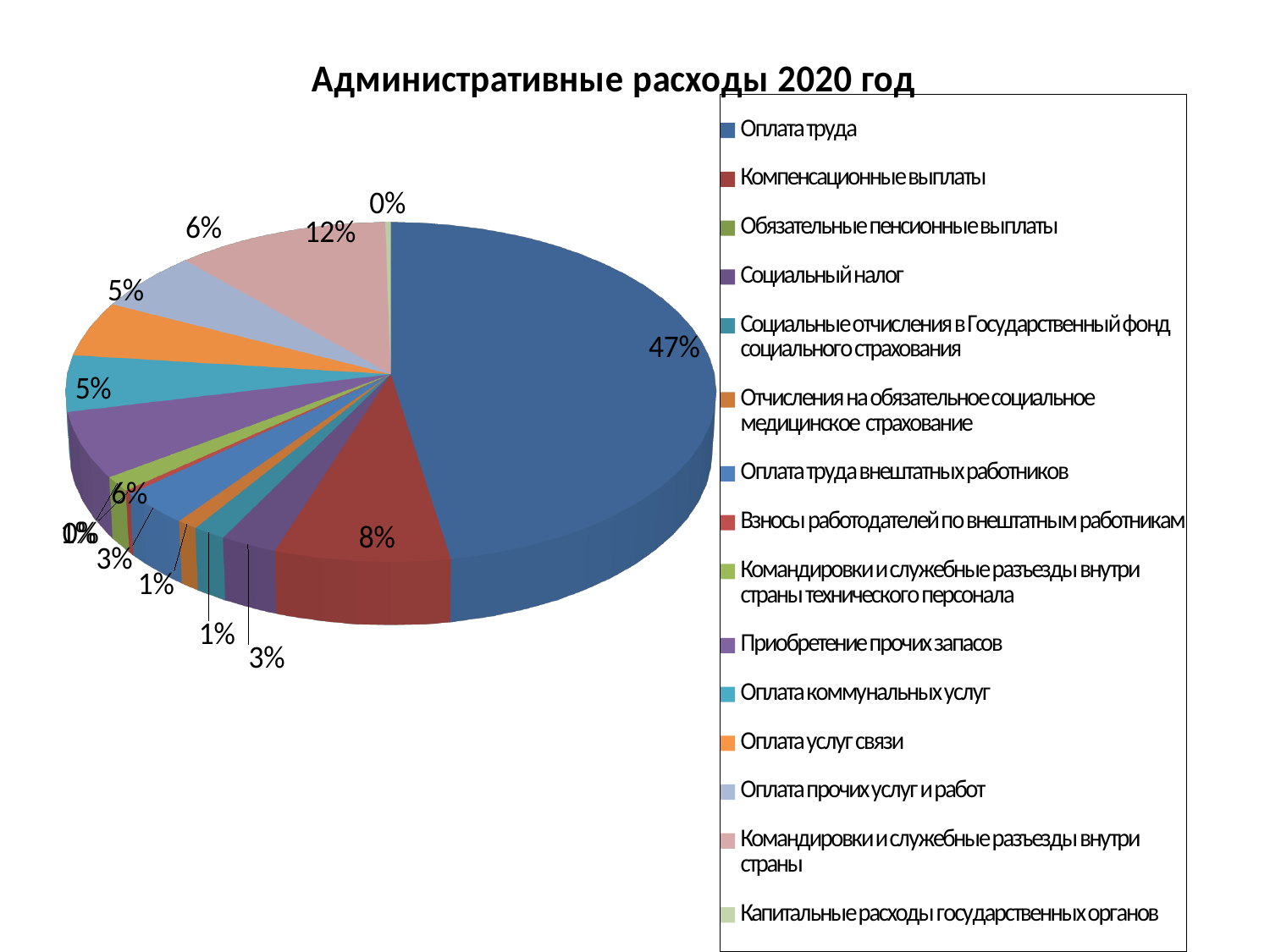
What share of the pie is Капитальные расходы государственных органов? 0% What share of the pie is Оплата прочих услуг и работ? 6% What share of the pie is Компенсационные выплаты? 8% What share of the pie is Командировки и служебные разъезды внутри страны? 12% By how many percentage points does the share for Оплата труда exceed the share for Командировки и служебные разъезды внутри страны? 35 Which category has the largest share of the pie? Оплата труда Which is larger: the share for Оплата труда or the share for Компенсационные выплаты? Оплата труда How many categories does the legend list? 15 What is the title of the chart? Административные расходы 2020 год What kind of chart is shown on the slide? Pie chart What share of the pie is Оплата труда? 47%